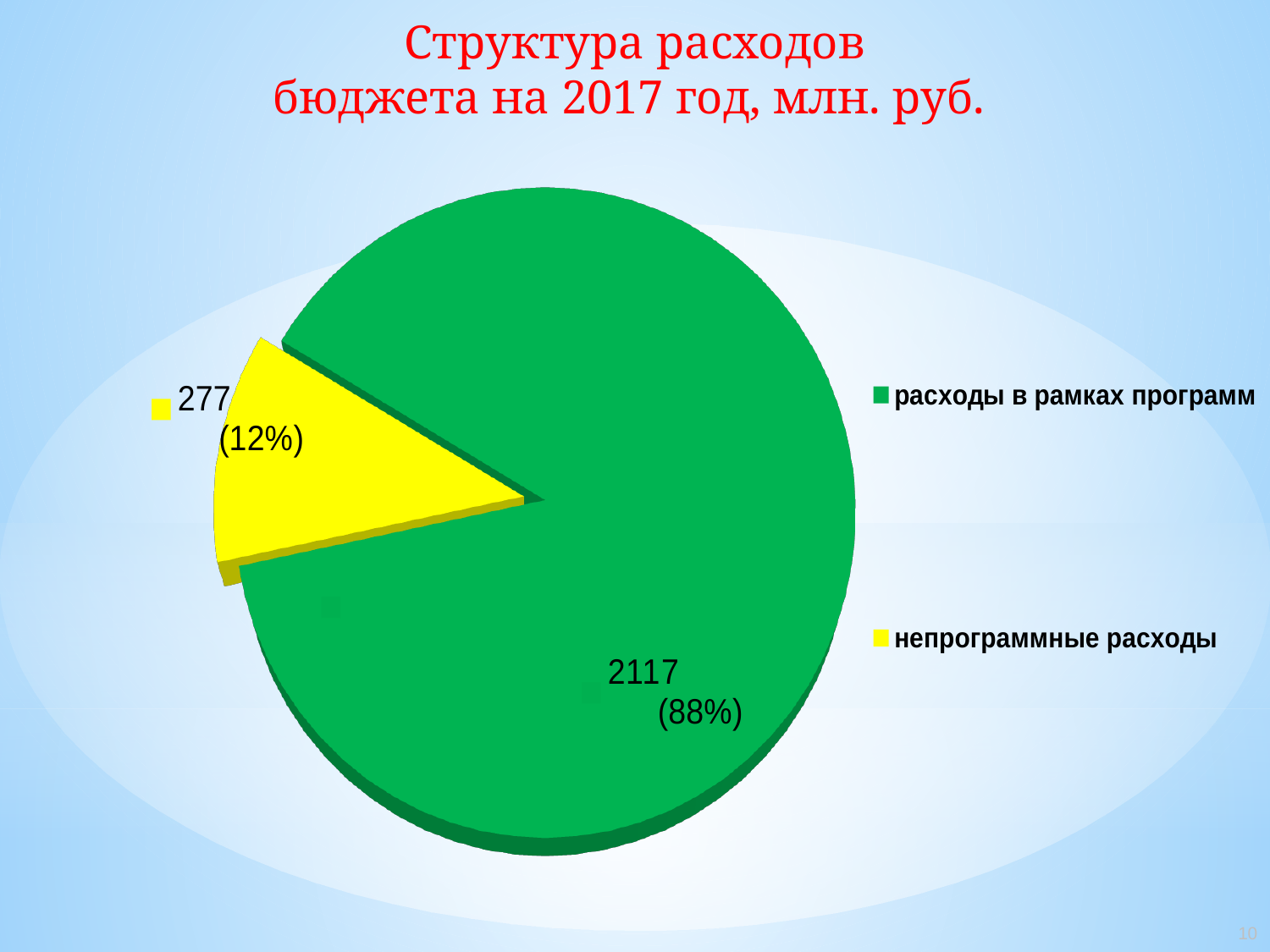
How many slices does the pie chart have? 2 Which category has the largest slice of the pie? расходы в рамках программ What is the difference between расходы в рамках программ and непрограммные расходы? 1840 Which is larger, расходы в рамках программ or непрограммные расходы? расходы в рамках программ What kind of chart is shown on the slide? pie chart What is the value for расходы в рамках программ? 2117 Which category has the smallest slice of the pie? непрограммные расходы What share of the pie does расходы в рамках программ represent? 88% What is the value for непрограммные расходы? 277 What is the total of the two slices in the pie chart? 2394 What colour is the slice for непрограммные расходы? yellow What share of the pie does непрограммные расходы represent? 12%